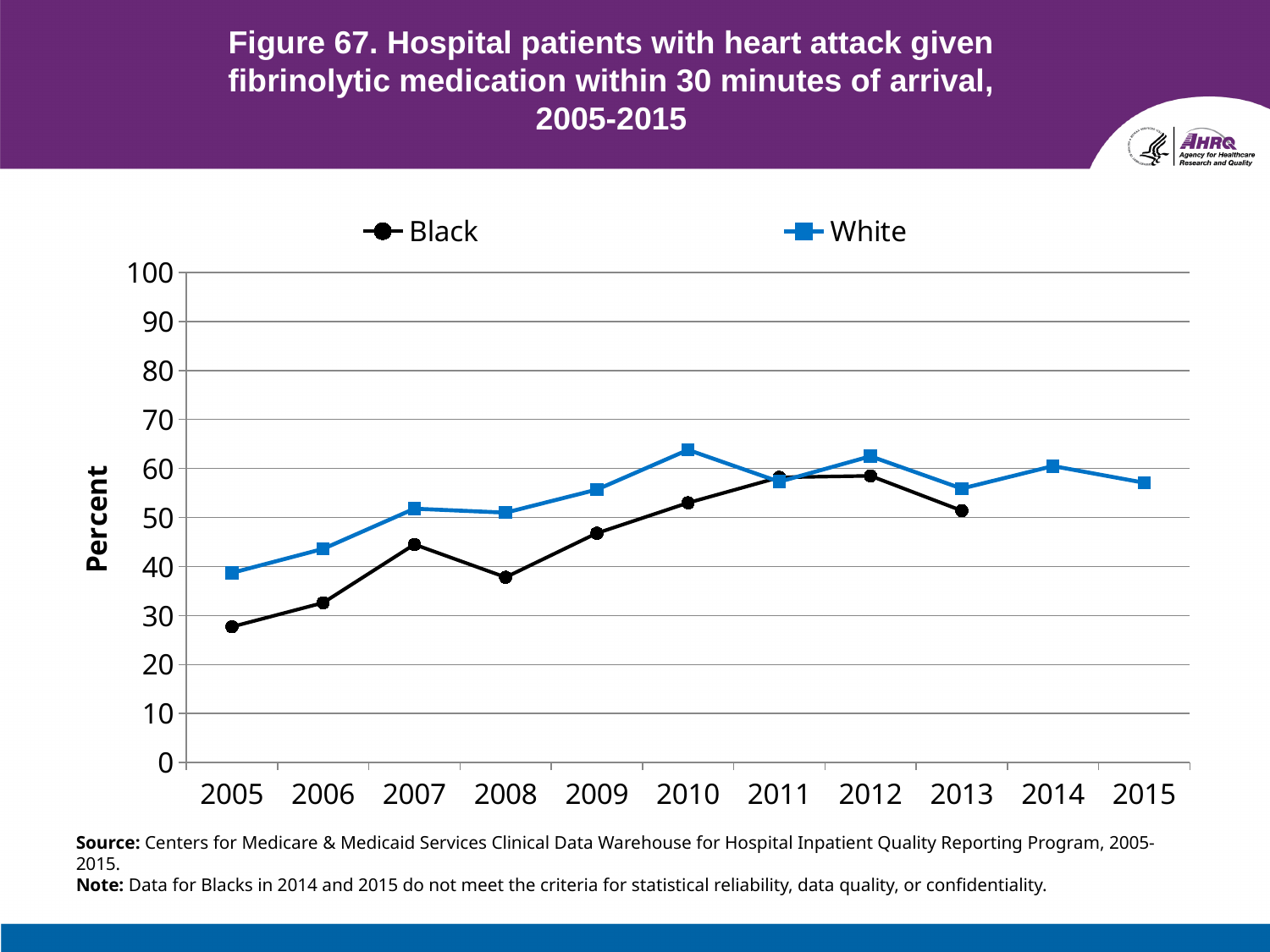
What kind of chart is shown on the slide? line chart Is the value for Black in 2005 greater or less than 30? less What colour is the line for the White series? blue How many data points are plotted for the Black series? 9 What is the label on the y axis? Percent How many series does the legend list? 2 Is the value for Black in 2008 greater or less than 40? less Does the Black series rise or fall from 2005 to 2007? rise In 2005, which series has the larger value, Black or White? White Is the value for White in 2010 greater or less than 60? greater In which year is the Black series at its lowest? 2005 How many years are shown on the x axis? 11